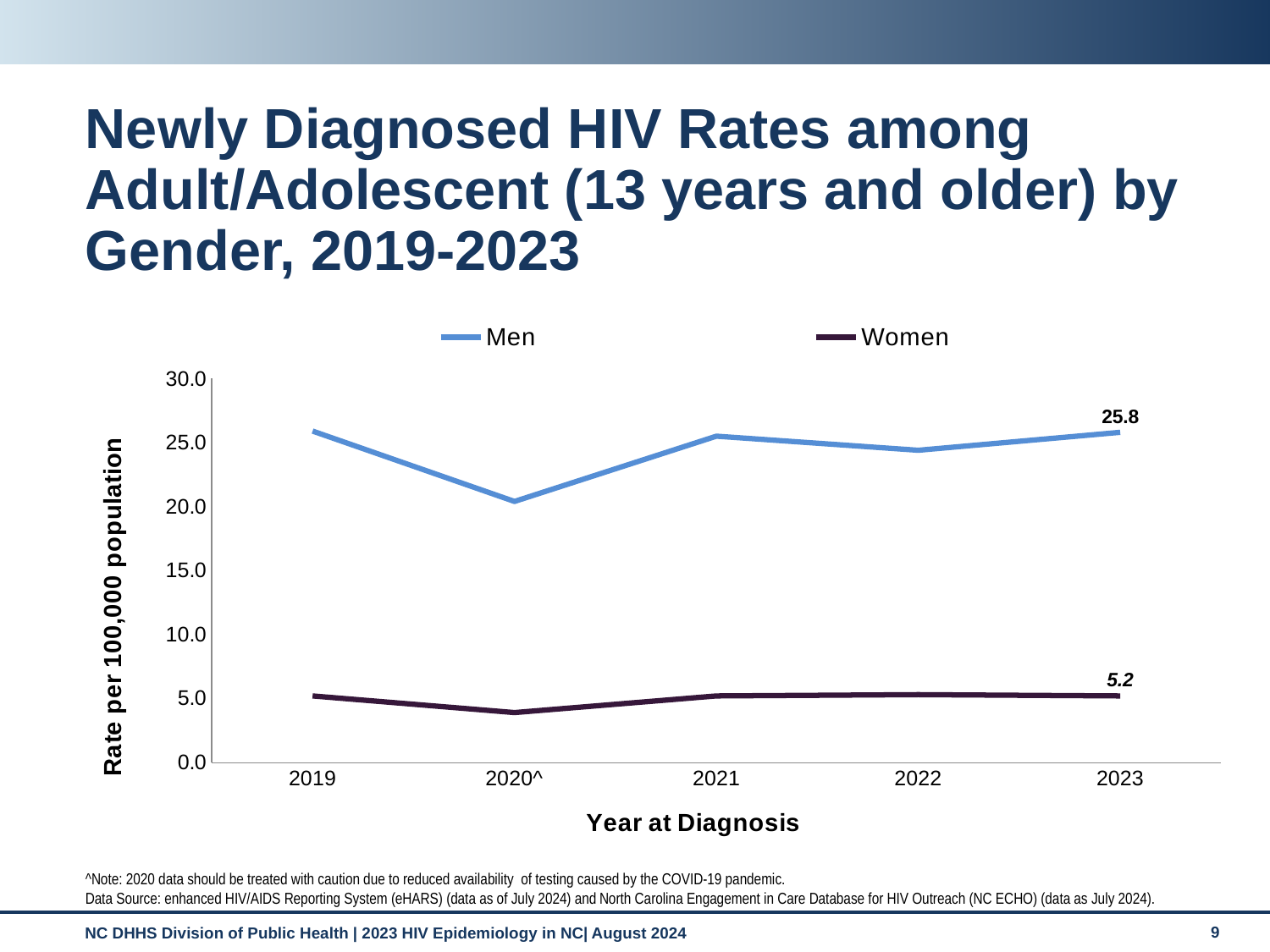
How many series does the legend list? 2 What is the rate for Men in 2023? 25.8 What is the rate for Women in 2023? 5.2 Is the rate for Men in 2020^ greater or less than 25.0? less In which year is the rate for Men lowest? 2020^ Is the rate for Men in 2019 greater or less than 20.0? greater What is the difference between the Men and Women rates in 2023? 20.6 How many years are shown on the x axis? 5 Is the rate for Women in 2019 greater or less than 10.0? less Which series has the higher rate in 2023, Men or Women? Men What kind of chart is shown on the slide? line chart What is the label of the y axis? Rate per 100,000 population